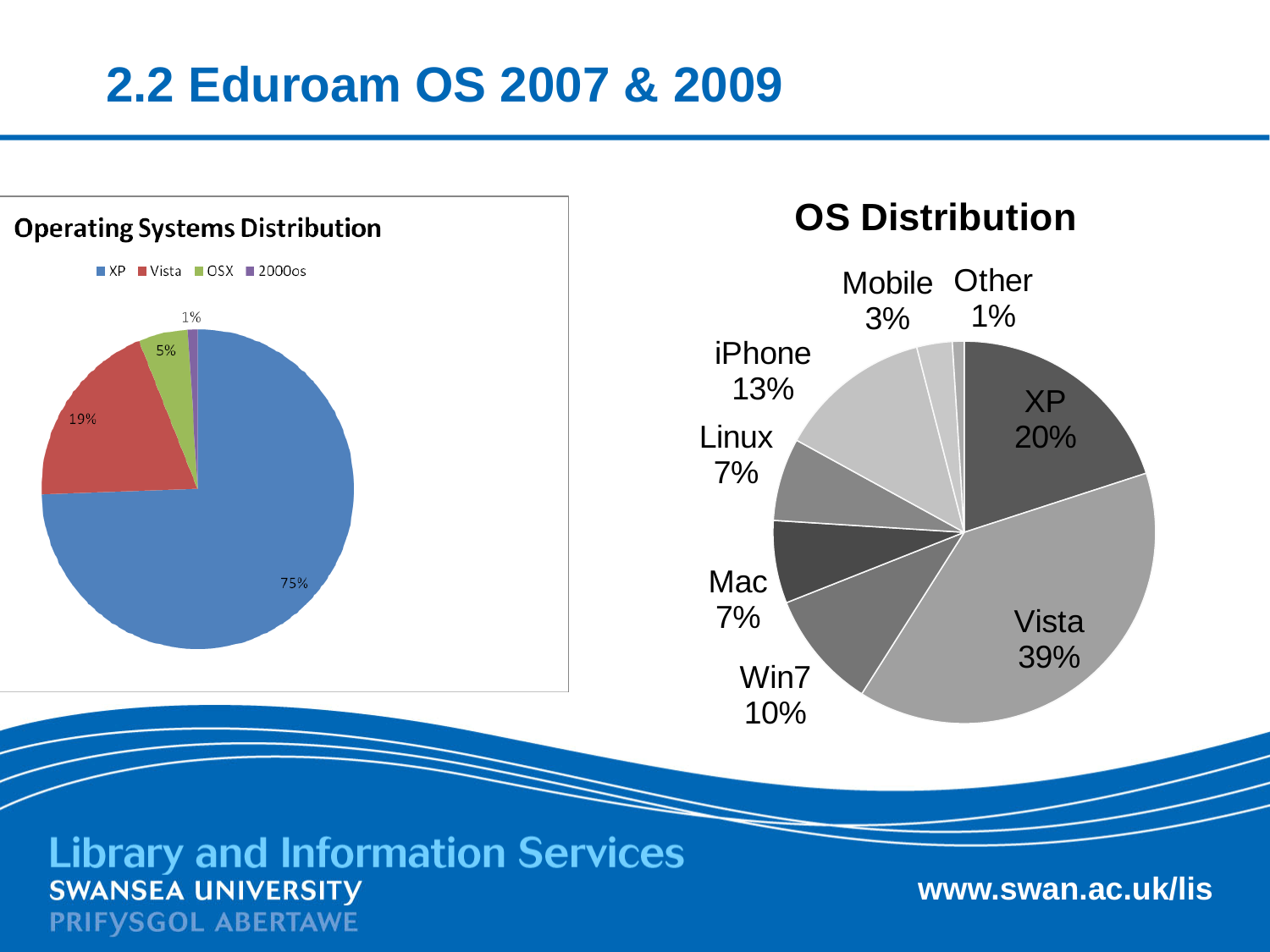
In the left chart titled "Operating Systems Distribution", what is the difference between the XP and Vista shares? 56% In the right chart titled "OS Distribution", what is the difference between the Vista and XP shares? 19% What kind of chart is the right chart titled "OS Distribution"? Pie chart In the right chart titled "OS Distribution", which is larger, Win7 or Mac? Win7 In the right chart titled "OS Distribution", how many categories are shown? 8 In the right chart titled "OS Distribution", which category has the largest slice? Vista In the left chart titled "Operating Systems Distribution", how many entries does the legend list? 4 In the right chart titled "OS Distribution", what share does iPhone have? 13% In the left chart titled "Operating Systems Distribution", which operating system has the smallest slice? 2000os In the left chart titled "Operating Systems Distribution", what share does Vista have? 19% In the right chart titled "OS Distribution", what share does Vista have? 39% In the left chart titled "Operating Systems Distribution", what share does XP have? 75%